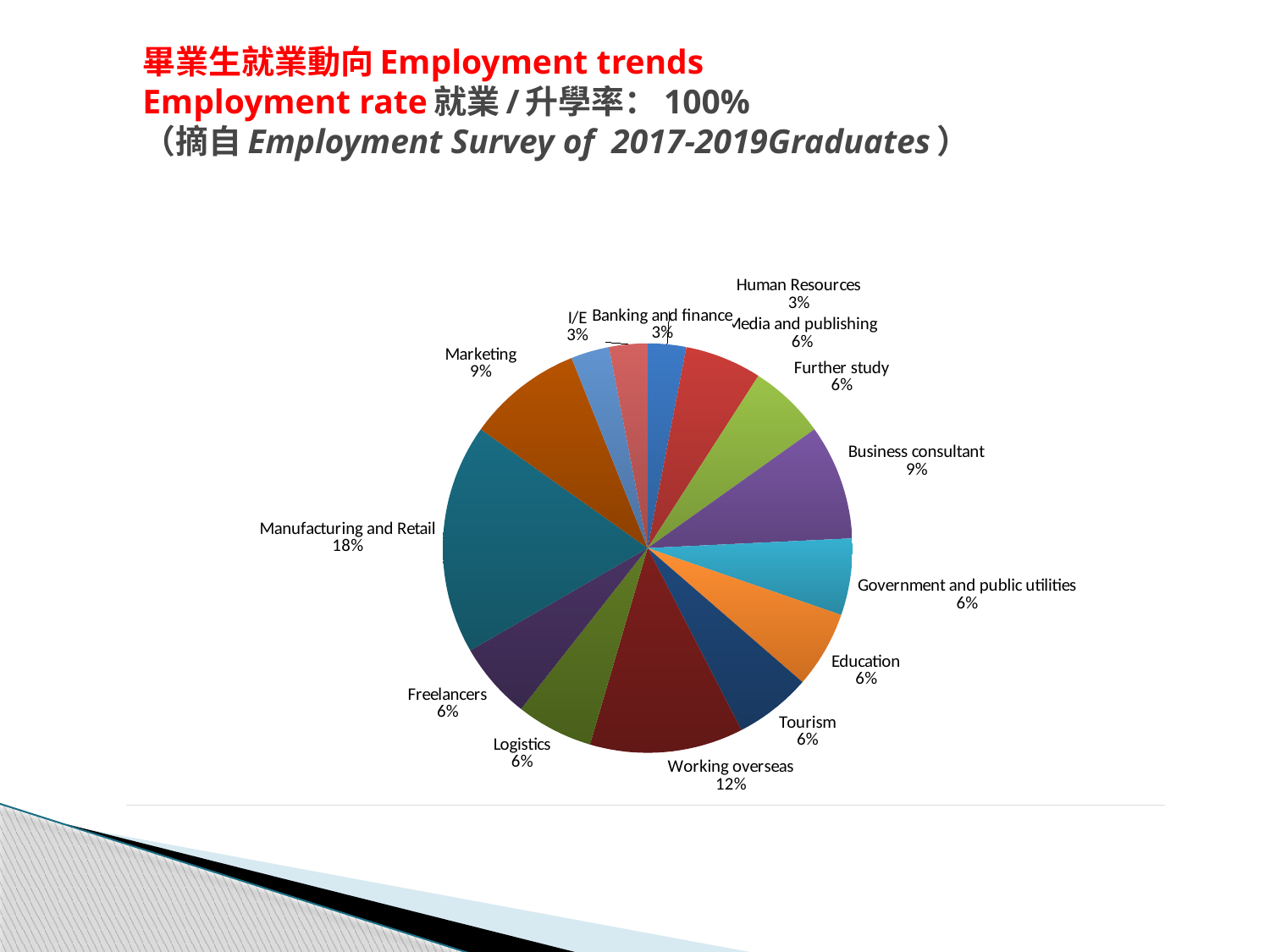
How many slices does the pie chart have? 14 What is the value shown for Working overseas? 12% What employment rate is stated in the slide title? 100% What is the difference between the Business consultant share and the Banking and finance share? 6% What share of the pie does Manufacturing and Retail have? 18% What kind of chart is shown on the slide? pie chart Which category has the largest slice of the pie? Manufacturing and Retail What is the value shown for Human Resources? 3% Which is larger, the share for Marketing or the share for Tourism? Marketing What is the value shown for Government and public utilities? 6% What is the difference between the Manufacturing and Retail share and the Working overseas share? 6% What is the value shown for Business consultant? 9%